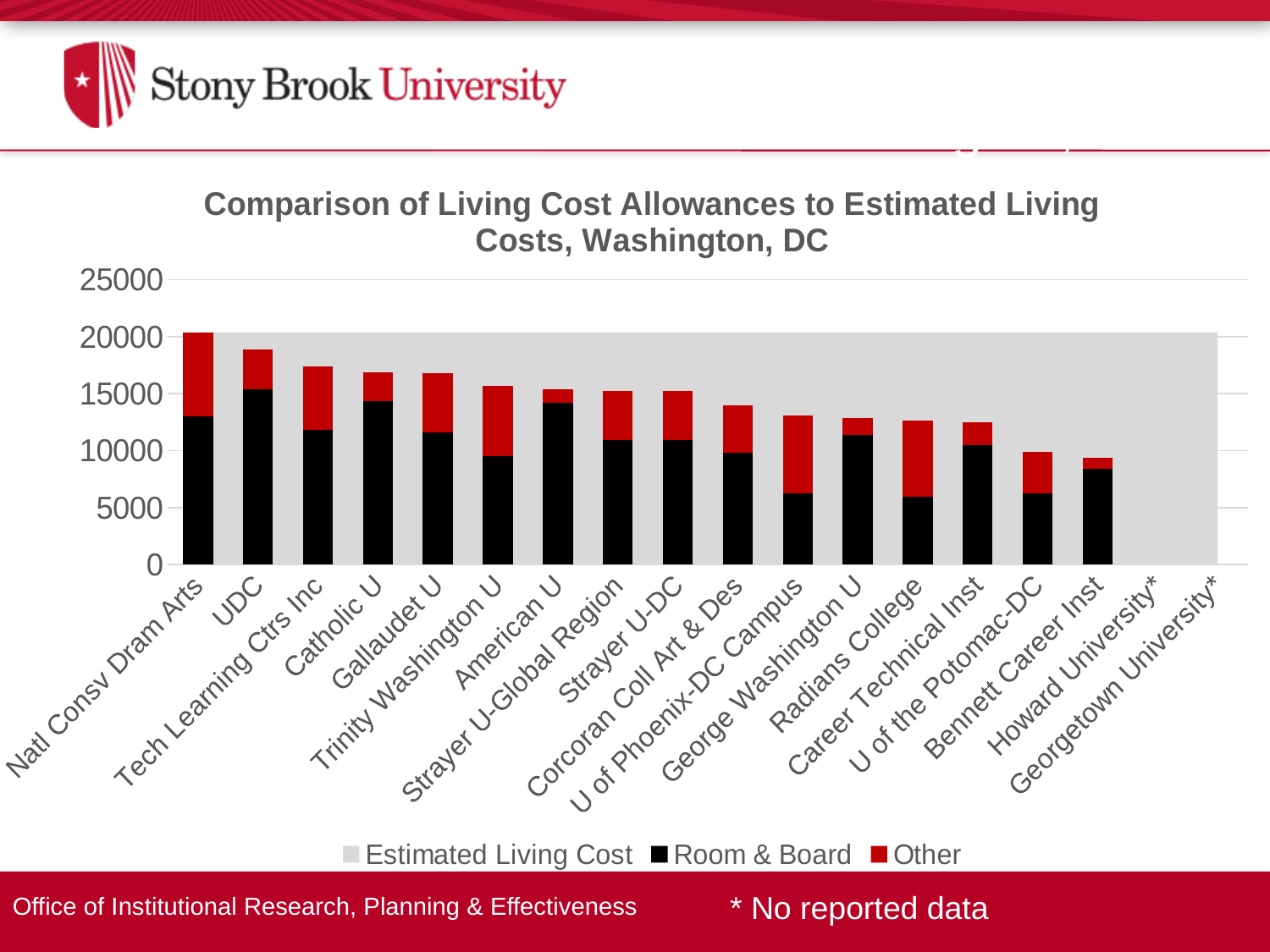
Which institution has the largest Room & Board allowance? UDC Is the total allowance for UDC greater or less than 20000? less What kind of chart is shown on the slide? Stacked bar chart Which institution has the highest total living cost allowance (Room & Board plus Other)? Natl Consv Dram Arts How many institutions are labelled on the x axis? 18 Which two institutions are marked with an asterisk as having no reported data? Howard University and Georgetown University How many series does the legend list? 3 Is the Estimated Living Cost level shown in grey greater or less than 15000? greater Which has the larger Room & Board allowance, UDC or Natl Consv Dram Arts? UDC Do the total allowances generally rise or fall moving from left to right along the x axis? fall Is the total allowance for Bennett Career Inst greater or less than 10000? less